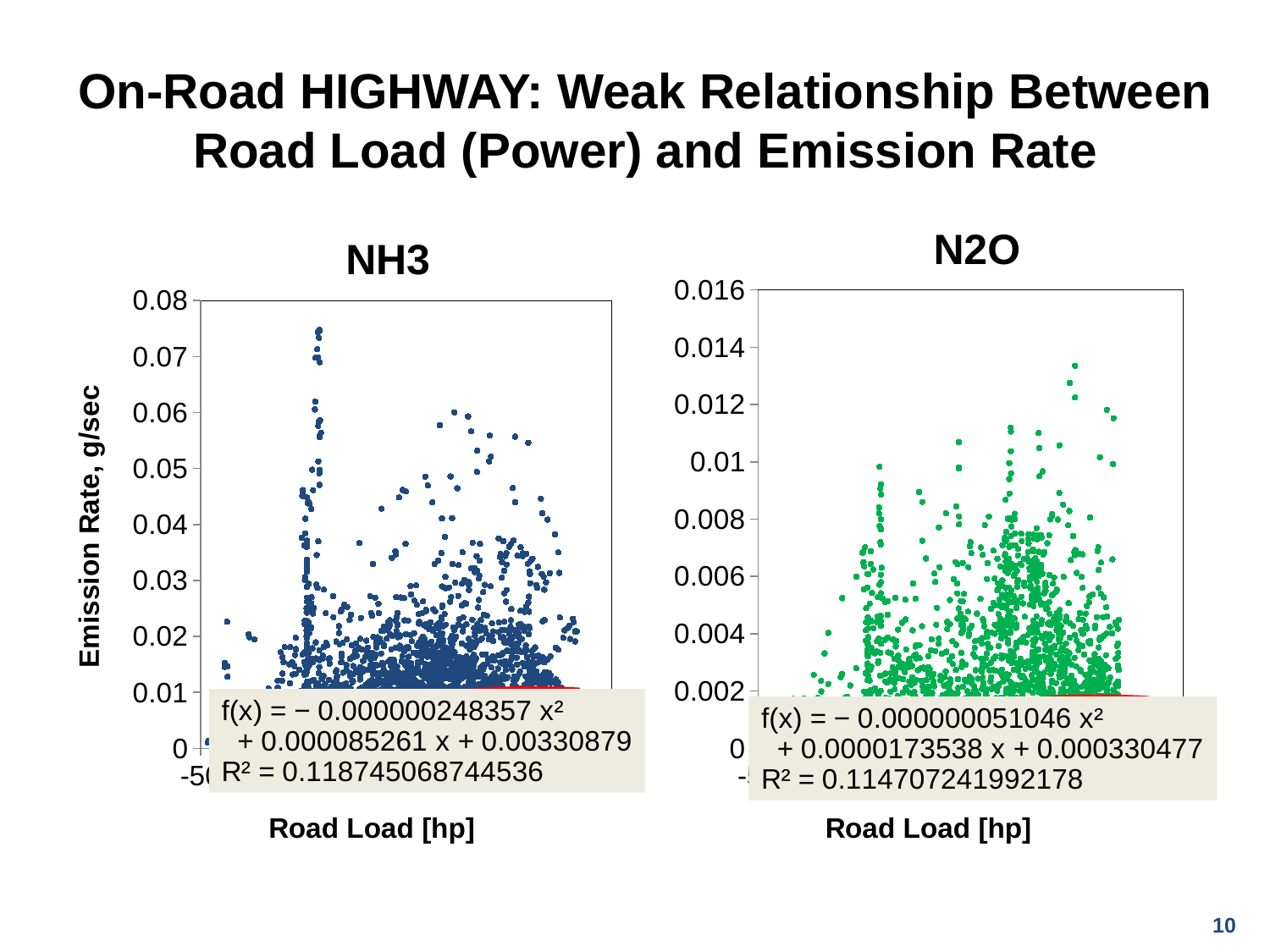
What kind of chart is the NH3 chart on the left? scatter chart Which chart has the higher printed R² value, NH3 or N2O? NH3 What is the x-axis label on the NH3 chart? Road Load [hp] What kind of chart is the N2O chart on the right? scatter chart In the N2O chart, what is the highest value shown on the y axis? 0.016 In the N2O chart, is the highest plotted emission rate greater or less than 0.012? greater In the NH3 chart, what is the R² value printed for the fitted trendline? 0.118745068744536 In the NH3 chart, what is the highest value shown on the y axis? 0.08 What is the y-axis label on the NH3 chart? Emission Rate, g/sec In the NH3 chart, is the highest plotted emission rate greater or less than 0.07? greater In the N2O chart, is the highest plotted emission rate greater or less than 0.014? less In the N2O chart, what is the R² value printed for the fitted trendline? 0.114707241992178